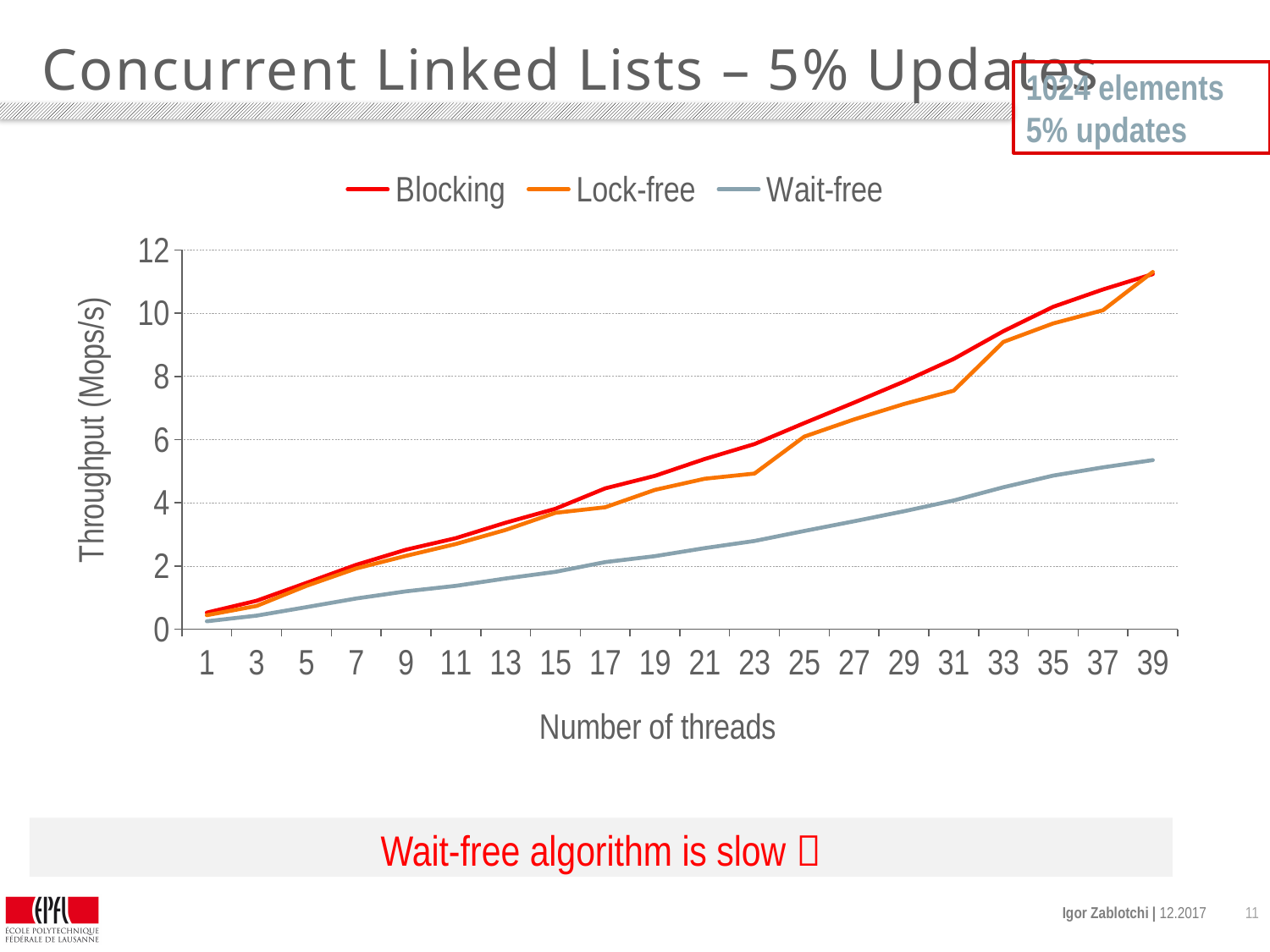
At 39 threads, is the Blocking throughput greater or less than 10? greater At 31 threads, is the Lock-free throughput greater or less than 6? greater What are the three series named in the legend? Blocking, Lock-free, Wait-free At 25 threads, which is larger: the Lock-free throughput or the Wait-free throughput? Lock-free Does the Wait-free throughput rise or fall as the number of threads increases? rise What is the label of the y axis? Throughput (Mops/s) At 39 threads, is the Wait-free throughput greater or less than 6? less How many series does the legend list? 3 Which series has the highest throughput at 31 threads? Blocking Which series has the lowest throughput at 39 threads? Wait-free What kind of chart is shown on the slide? line chart